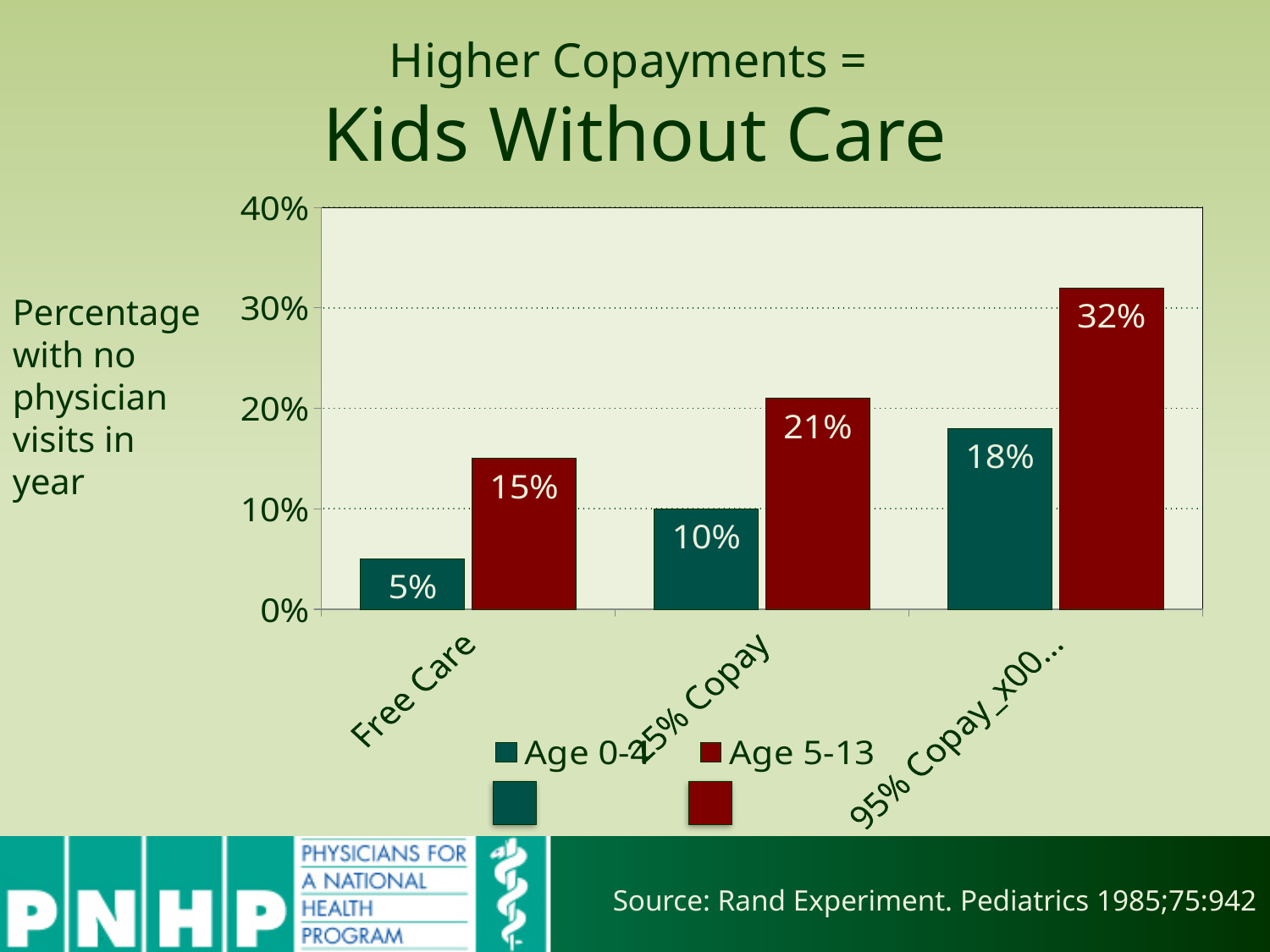
How many series does the legend list? 2 What type of chart is shown on the slide? bar chart What is the difference between the Age 5-13 values for 95% Copay and Free Care? 17% What is the value of the teal bar under 95% Copay? 18% What is the value for Age 5-13 under 25% Copay? 21% Which category has the highest value for Age 5-13? 95% Copay What is the value for Age 5-13 under 95% Copay? 32% Do the Age 5-13 values rise or fall from Free Care to 95% Copay? rise What is the value of the teal bar under 25% Copay? 10% What is the value for Age 5-13 under Free Care? 15% Which is larger: the Age 5-13 value under 25% Copay or the teal bar under 95% Copay? Age 5-13 under 25% Copay What is the value of the teal bar under Free Care? 5%